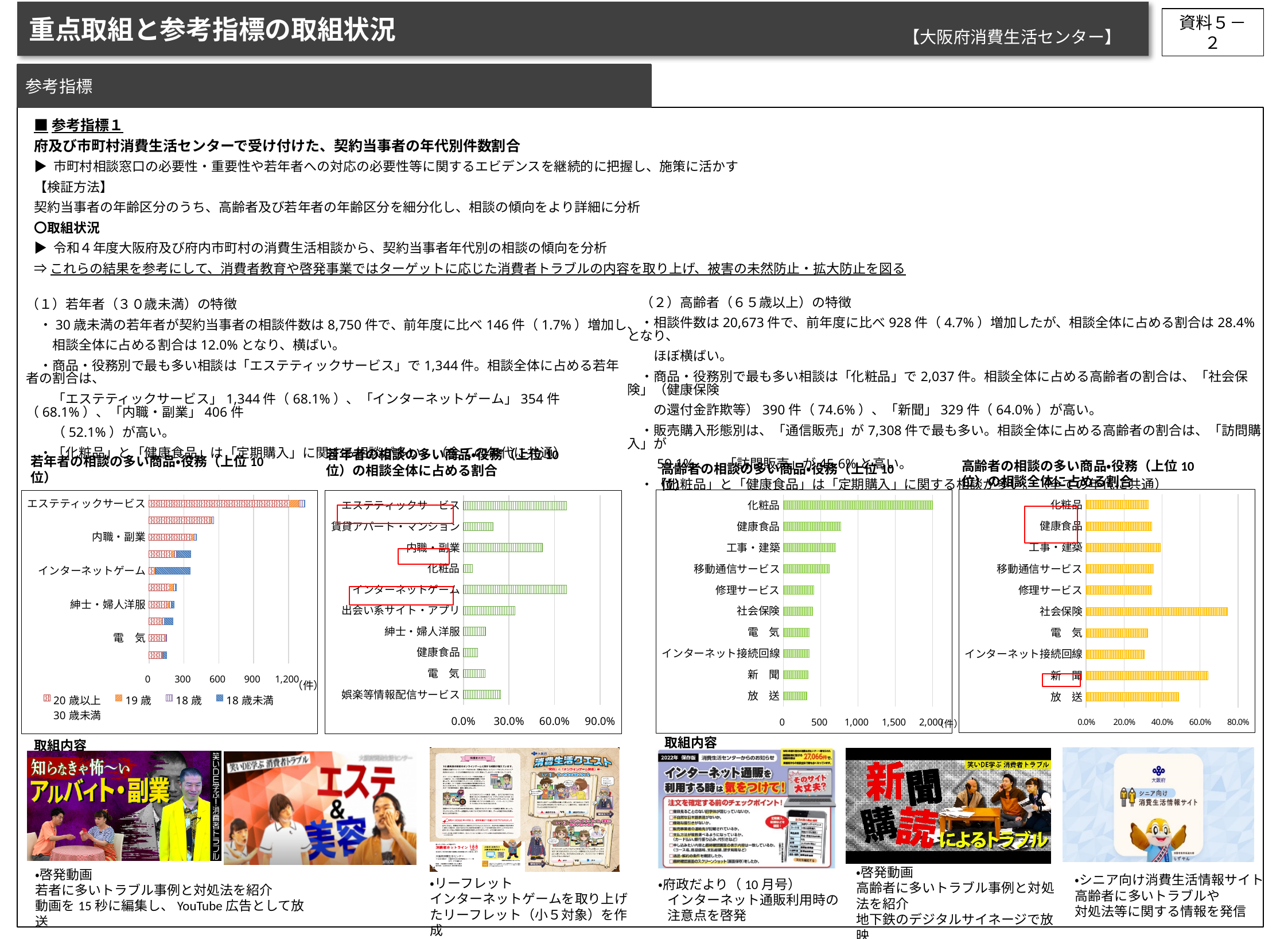
In the chart titled 高齢者の相談の多い商品・役務（上位10位）, which category has the highest value? 化粧品 In the chart titled 若年者の相談の多い商品・役務（上位10位）, is the total bar for エステティックサービス greater or less than 1,200? greater In the chart titled 若年者の相談の多い商品・役務（上位10位）, which category has the longest bar? エステティックサービス In the chart titled 若年者の相談の多い商品・役務（上位10位）の相談全体に占める割合, is the value for 化粧品 greater or less than 30.0%? less In the chart titled 若年者の相談の多い商品・役務（上位10位）, how many series does the legend list? 4 In the chart titled 高齢者の相談の多い商品・役務（上位10位）の相談全体に占める割合, which is larger, the value for 社会保険 or the value for 化粧品? 社会保険 In the chart titled 若年者の相談の多い商品・役務（上位10位）の相談全体に占める割合, how many categories are plotted? 10 In the chart titled 高齢者の相談の多い商品・役務（上位10位）, is the value for 健康食品 greater or less than 1,000? less In the chart titled 若年者の相談の多い商品・役務（上位10位）, what kind of chart is shown? bar chart In the chart titled 高齢者の相談の多い商品・役務（上位10位）の相談全体に占める割合, which category has the highest value? 社会保険